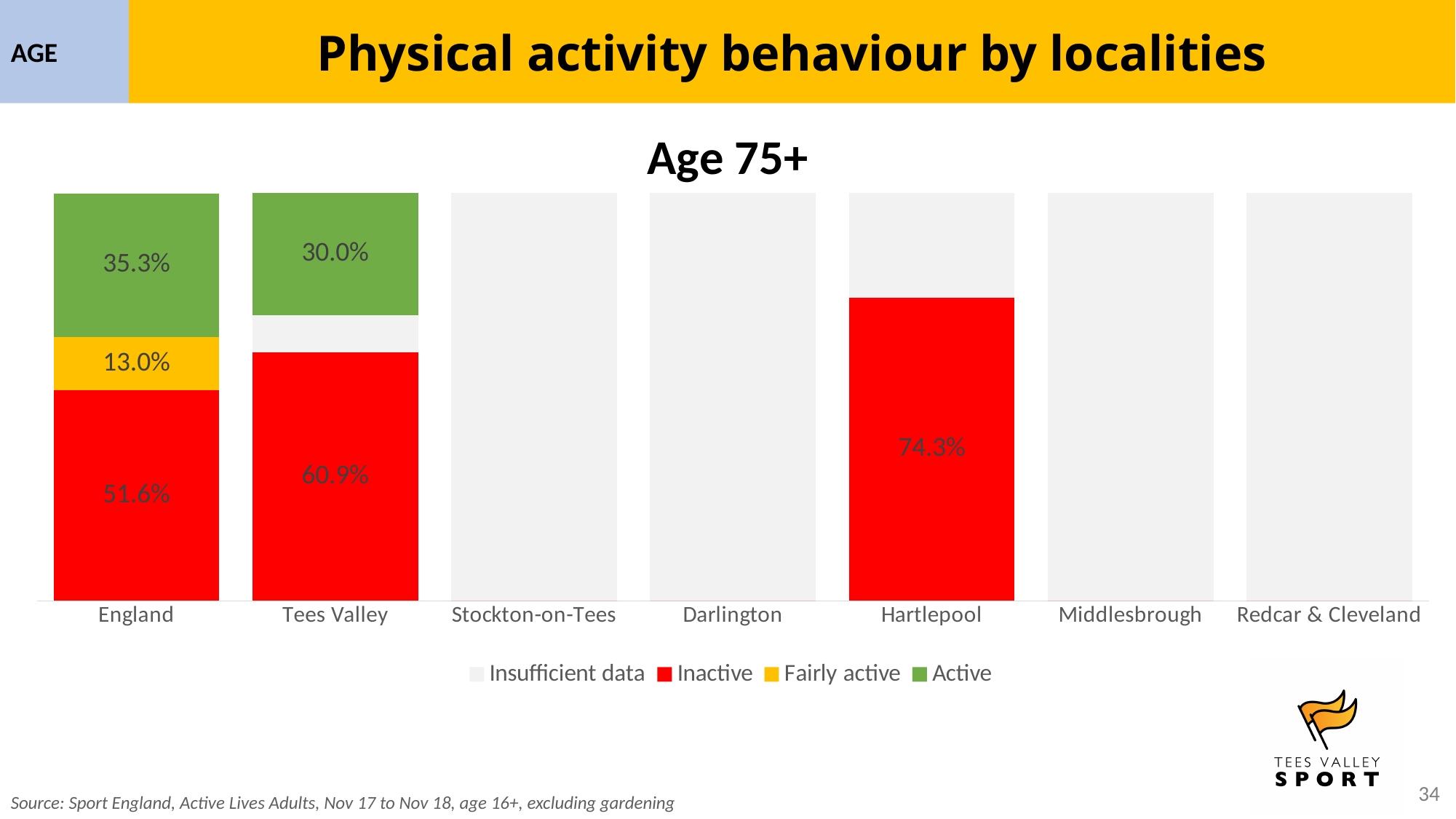
Which has a larger Active percentage, England or Tees Valley? England What is the Inactive percentage for Hartlepool? 74.3% How many localities are shown on the x axis of the chart? 7 What is the Fairly active percentage for England? 13.0% Which locality has the lowest labelled Inactive percentage? England How many series does the legend list? 4 Which locality has the highest labelled Inactive percentage? Hartlepool What is the difference between the Inactive percentages for Tees Valley and England? 9.3% What kind of chart is shown on the slide? Stacked bar chart What is the title of the chart? Age 75+ What is the Inactive percentage for England in the Age 75+ chart? 51.6% What is the Active percentage for Tees Valley? 30.0%